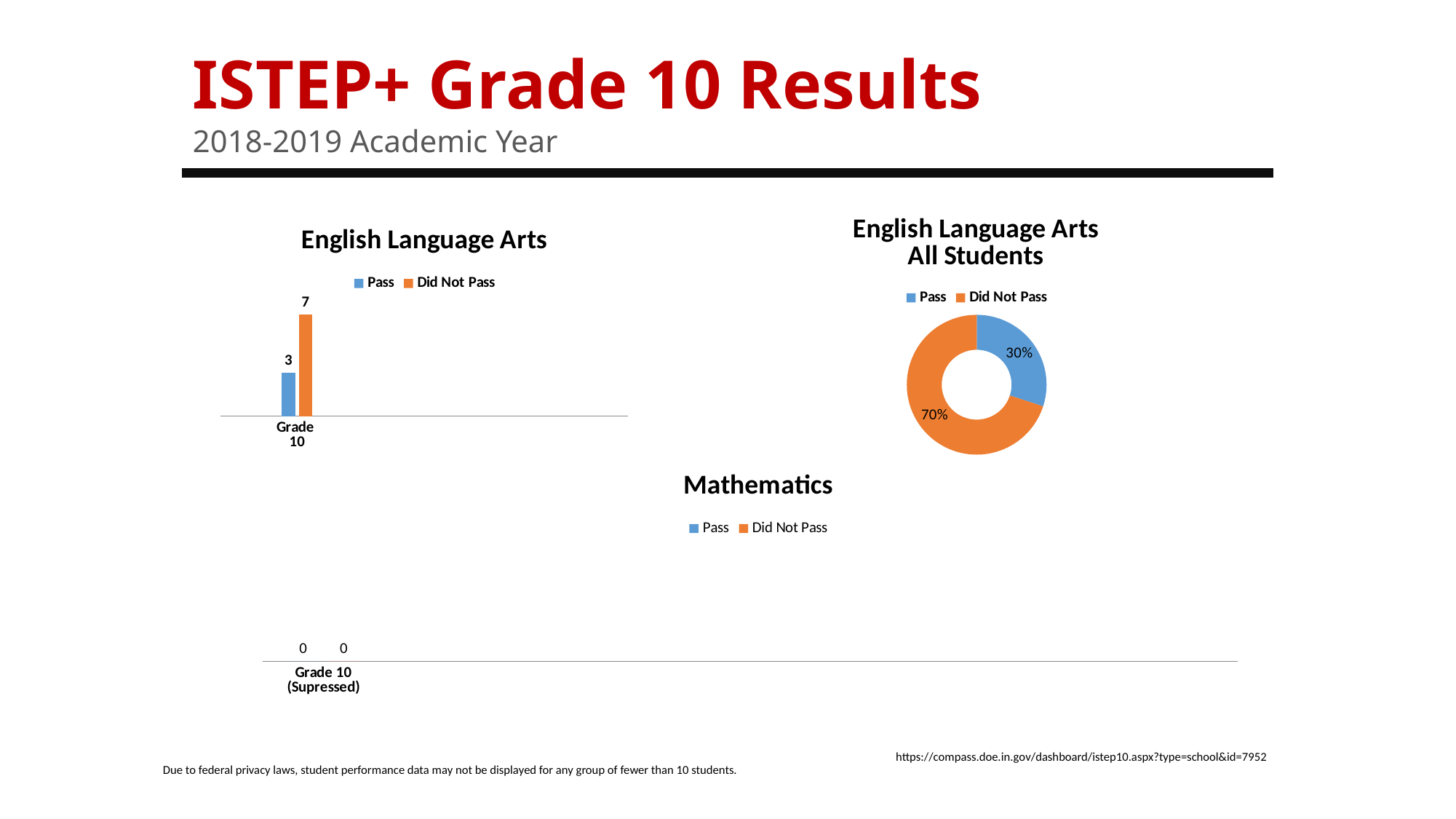
In the 'English Language Arts' bar chart, which series has the higher value for Grade 10, Pass or Did Not Pass? Did Not Pass What kind of chart is the 'English Language Arts All Students' chart? Doughnut chart In the 'English Language Arts' bar chart, how many series does the legend list? 2 In the 'Mathematics' chart, what is the category label on the x axis? Grade 10 (Supressed) In the 'English Language Arts' bar chart, what is the value for Pass for Grade 10? 3 In the 'English Language Arts' bar chart, what is the value for Did Not Pass for Grade 10? 7 In the 'English Language Arts All Students' chart, which slice is larger, Pass or Did Not Pass? Did Not Pass In the 'English Language Arts' bar chart, what is the difference between Did Not Pass and Pass for Grade 10? 4 In the 'English Language Arts All Students' chart, what share of students is Did Not Pass? 70% In the 'English Language Arts All Students' chart, what share of students is Pass? 30% What kind of chart is the 'English Language Arts' chart on the left? Bar chart In the 'Mathematics' chart, what is the value for Pass for Grade 10 (Supressed)? 0